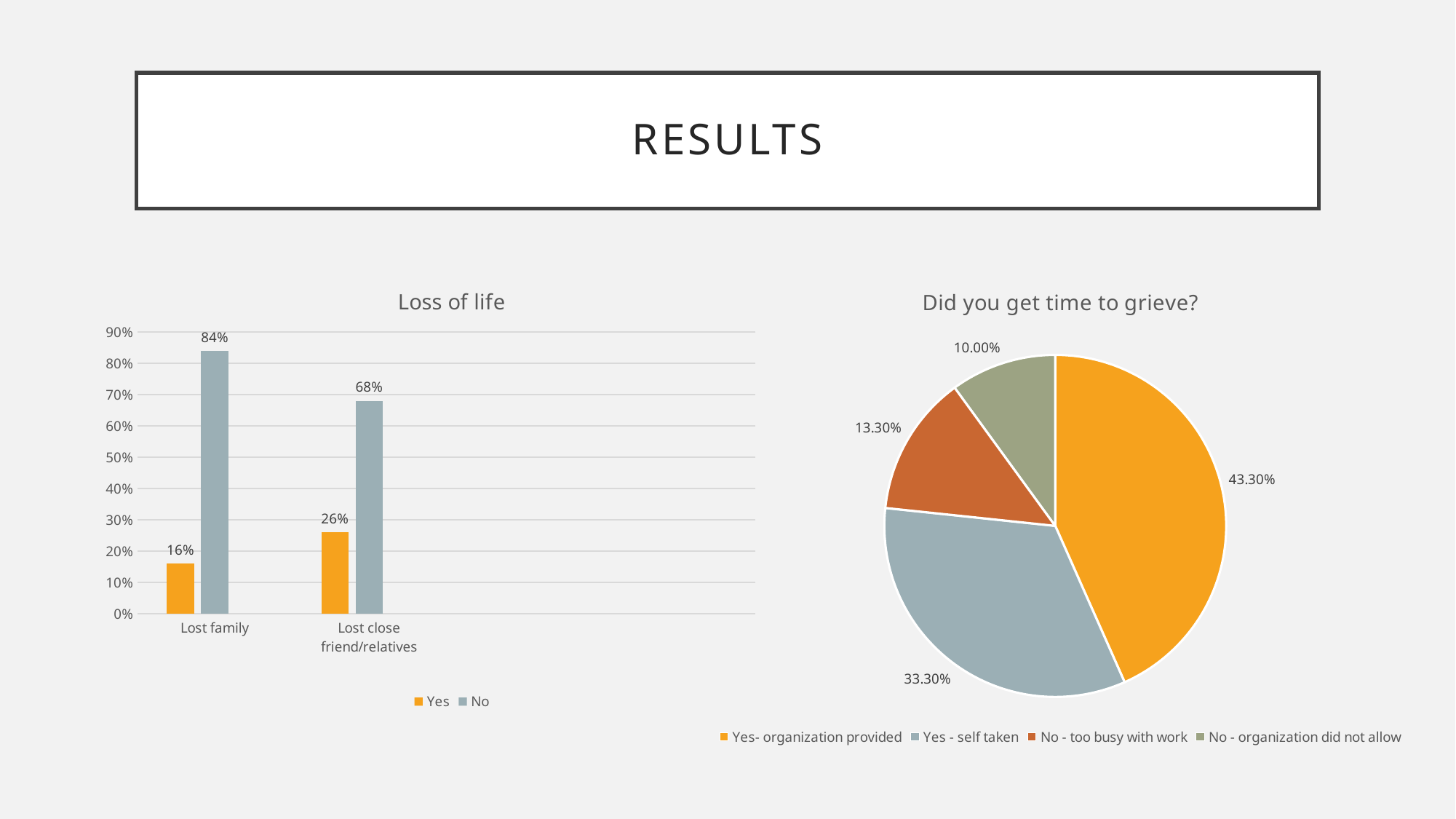
In the "Loss of life" chart, what is the value of the "Yes" bar for "Lost family"? 16% How many slices does the "Did you get time to grieve?" pie chart have? 4 What kind of chart is "Loss of life"? Bar chart In the "Did you get time to grieve?" chart, what share does "Yes - self taken" have? 33.30% In the "Did you get time to grieve?" chart, what is the difference between the "Yes- organization provided" and "No - too busy with work" slices? 30.00% What kind of chart is "Did you get time to grieve?"? Pie chart In the "Loss of life" chart, which is larger: the "Yes" value for "Lost family" or the "Yes" value for "Lost close friend/relatives"? Lost close friend/relatives In the "Loss of life" chart, which bar is the highest? No for Lost family (84%) In the "Loss of life" chart, what is the difference between the "No" and "Yes" values for "Lost family"? 68% In the "Loss of life" chart, what is the value of the "No" bar for "Lost close friend/relatives"? 68% In the "Loss of life" chart, how many series does the legend list? 2 In the "Did you get time to grieve?" chart, which slice is the smallest? No - organization did not allow